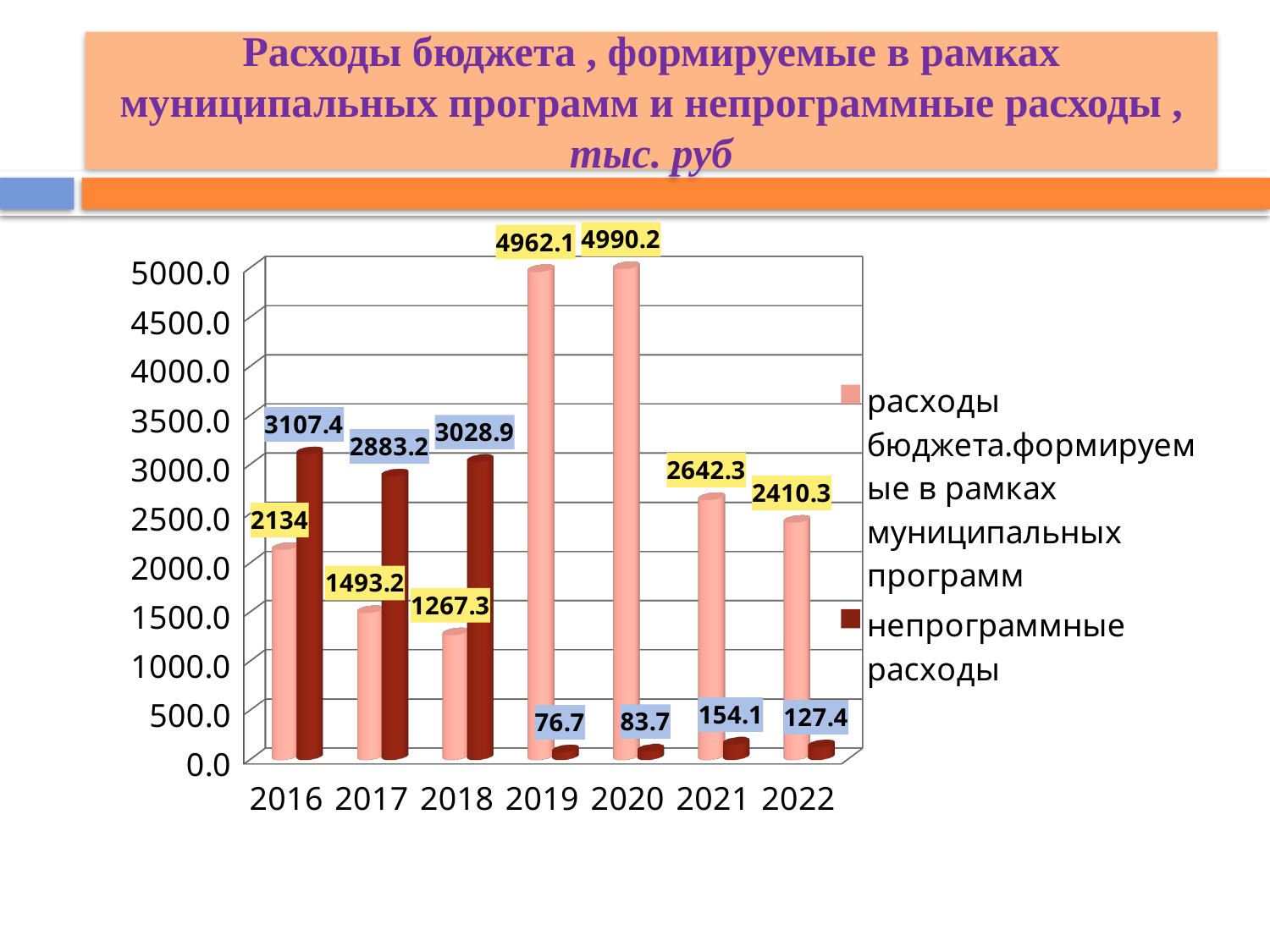
How many series does the legend list? 2 What is the value of расходы бюджета, формируемые в рамках муниципальных программ for 2019? 4962.1 What is the difference between непрограммные расходы in 2016 and in 2017? 224.2 What is the value of непрограммные расходы for 2022? 127.4 What colour are the bars for непрограммные расходы? dark red Which is larger in 2018: расходы бюджета, формируемые в рамках муниципальных программ or непрограммные расходы? непрограммные расходы In which year is the value of расходы бюджета, формируемые в рамках муниципальных программ the highest? 2020 In which year is the value of непрограммные расходы the lowest? 2019 What type of chart is shown on the slide? bar chart Is the value of расходы бюджета, формируемые в рамках муниципальных программ for 2021 greater or less than 2500.0? greater How many years are shown on the x axis? 7 What is the value of непрограммные расходы for 2016? 3107.4